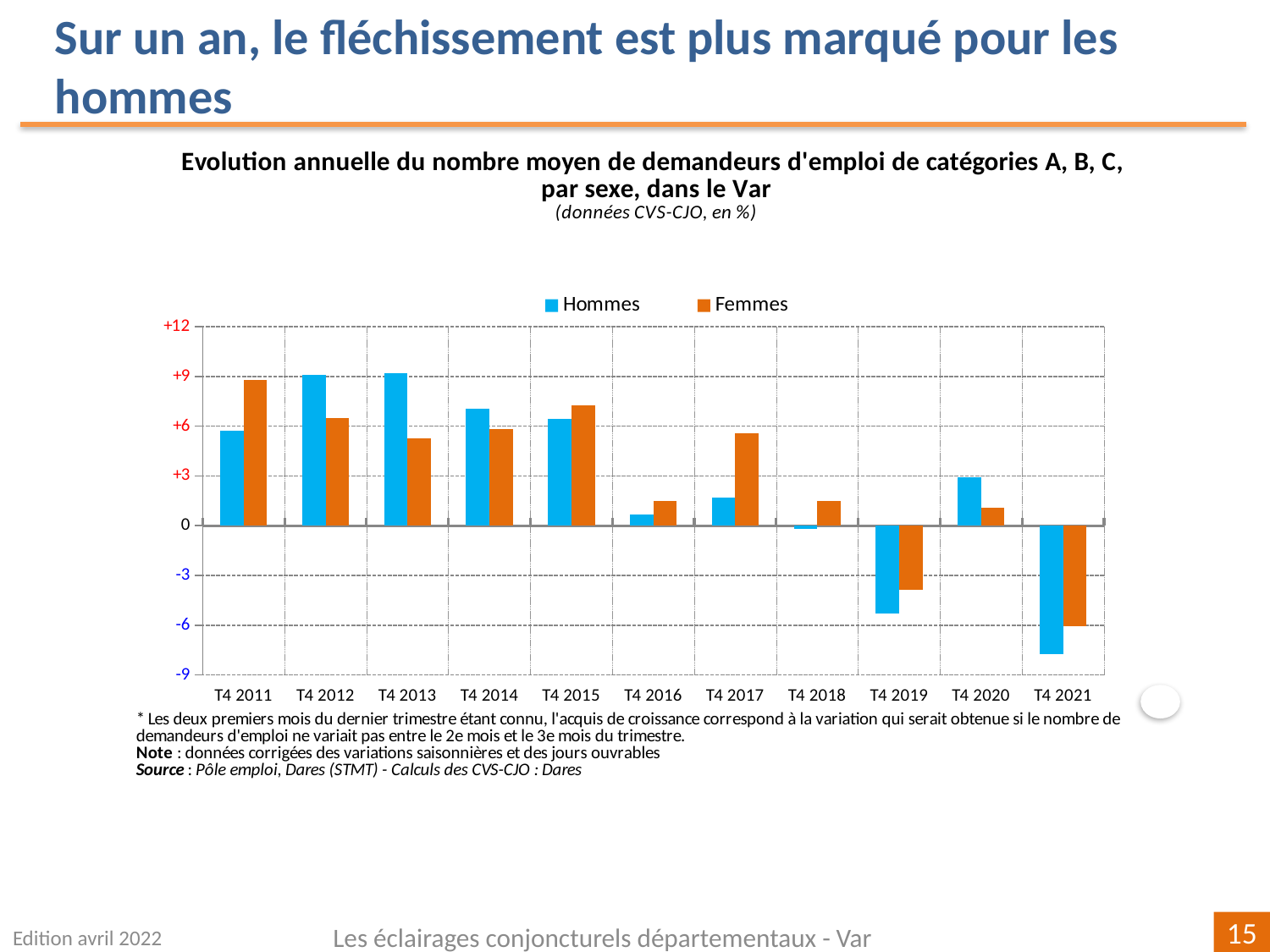
In which quarter is the value for Hommes the lowest? T4 2021 In T4 2017, which series has the larger value, Hommes or Femmes? Femmes Is the value for Hommes in T4 2019 greater or less than -3? less In T4 2020, which series has the larger value, Hommes or Femmes? Hommes In which quarter is the value for Femmes the lowest? T4 2021 How many series does the legend list? 2 In which quarter is the value for Femmes the highest? T4 2011 Is the value for Hommes in T4 2021 greater or less than -6? less Which series is shown in blue? Hommes What kind of chart is shown on the slide? bar chart Is the value for Femmes in T4 2011 greater or less than 6? greater How many quarters (categories) are shown on the x axis? 11